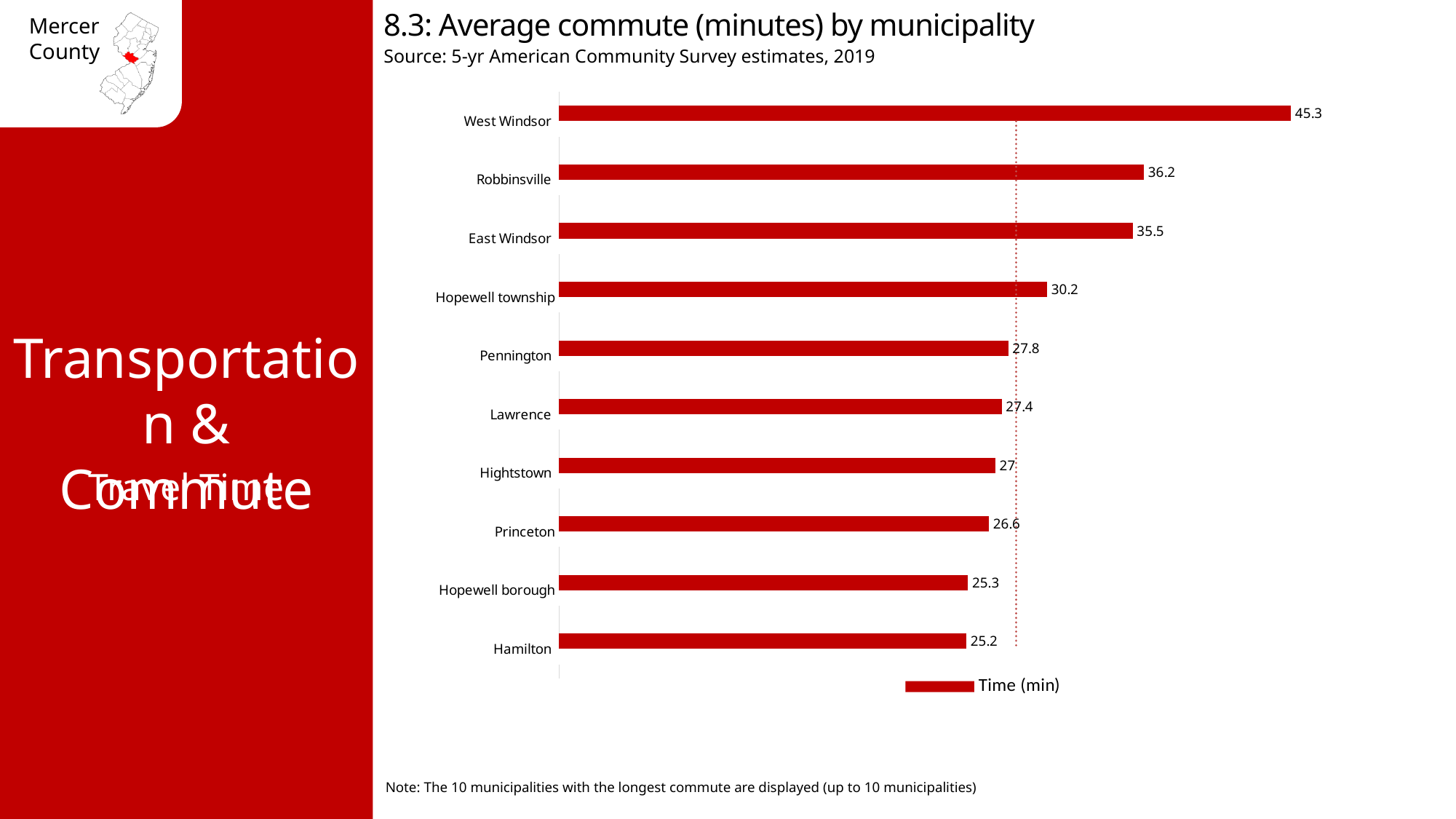
What kind of chart is used to show average commute by municipality? Bar chart Which municipality has the longest average commute? West Windsor Which has a longer average commute, Hopewell borough or Pennington? Pennington What is the average commute time for Hopewell township? 30.2 What is the average commute time for Princeton? 26.6 What is the average commute time for West Windsor? 45.3 What is the difference in average commute time between East Windsor and Hamilton? 10.3 What is the legend entry for the series on the chart? Time (min) Which has a longer average commute, Robbinsville or East Windsor? Robbinsville What is the difference in average commute time between West Windsor and Robbinsville? 9.1 How many municipalities are shown on the chart? 10 Which municipality has the shortest average commute shown on the chart? Hamilton